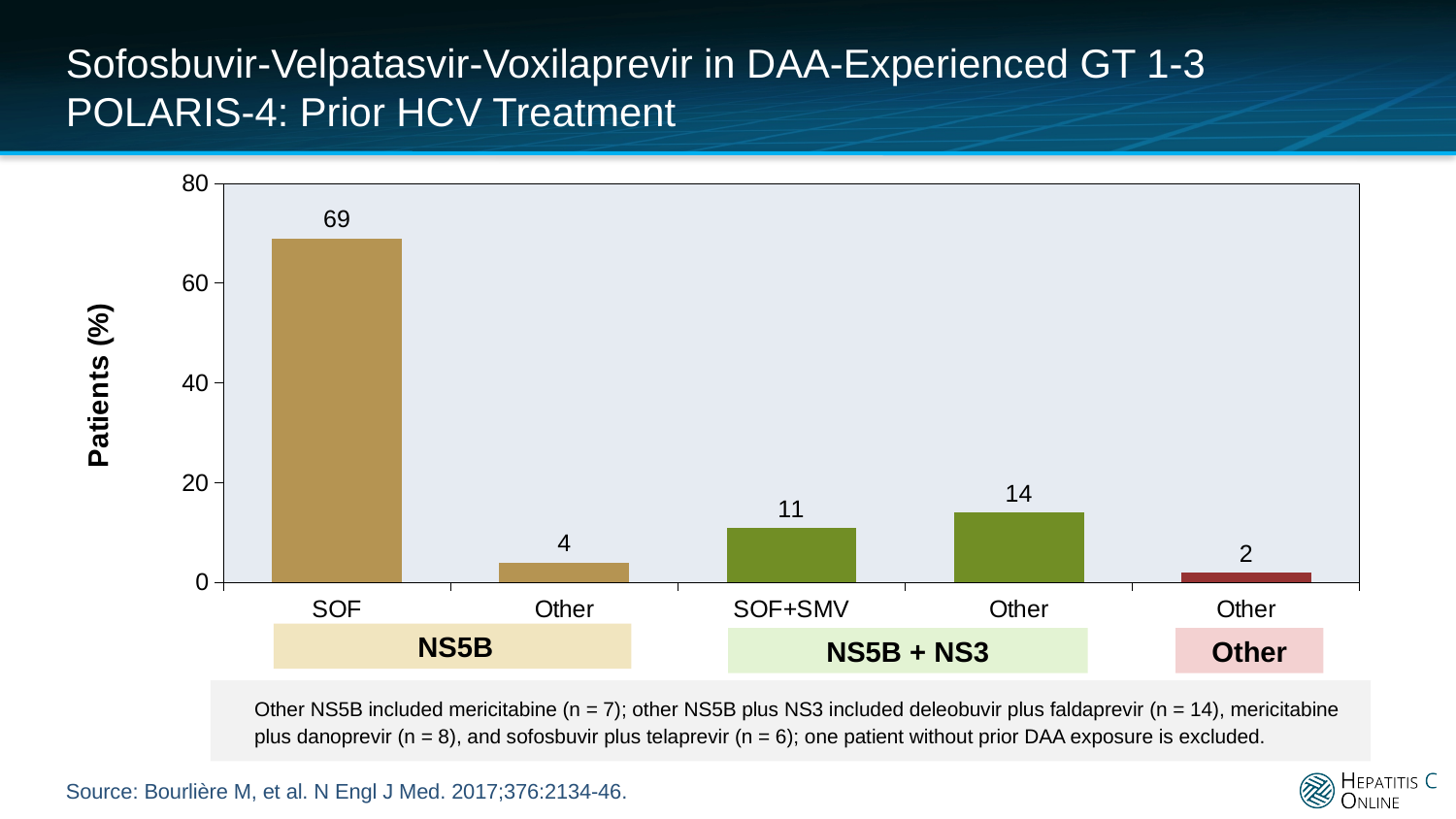
What type of chart is shown on the slide? Bar chart How many bars are plotted in the chart? 5 What percentage of patients had prior 'Other' treatment in the NS5B + NS3 group? 14 What is the label of the y-axis? Patients (%) What percentage of patients had prior SOF treatment in the NS5B group? 69 Which prior treatment category has the lowest percentage of patients? Other (the rightmost bar) Which prior treatment category has the highest percentage of patients? SOF What percentage of patients had prior SOF+SMV treatment in the NS5B + NS3 group? 11 What percentage of patients fall in the 'Other' category outside the NS5B and NS5B + NS3 groups? 2 What is the difference in percentage points between the SOF bar and the Other bar in the NS5B group? 65 Is the value for SOF greater or less than 60? greater Which is larger: the SOF+SMV bar or the Other bar in the NS5B + NS3 group? Other (14)